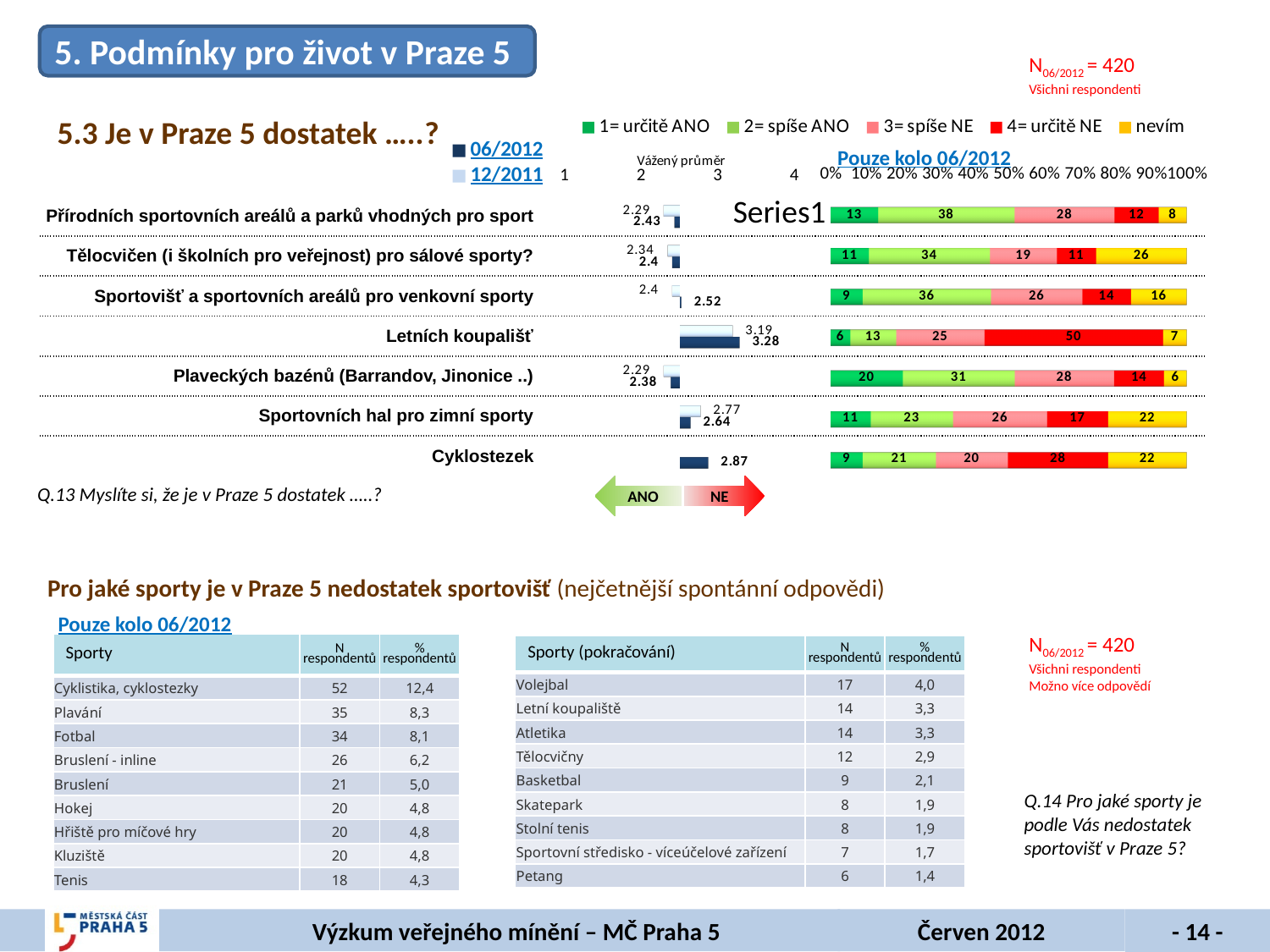
In the 'Vážený průměr' chart, what is the 06/2012 weighted average for 'Letních koupališť'? 3.28 How many categories are shown in the 'Pouze kolo 06/2012' stacked chart? 7 How many series does the legend of the 'Pouze kolo 06/2012' stacked chart list? 5 In the 'Vážený průměr' chart, what is the difference between the 12/2011 and 06/2012 values for 'Přírodních sportovních areálů a parků vhodných pro sport'? 0.14 In the 'Vážený průměr' chart, what is the 12/2011 weighted average for 'Sportovišť a sportovních areálů pro venkovní sporty'? 2.4 What kind of chart is the 'Pouze kolo 06/2012' chart? Stacked bar chart In the 'Pouze kolo 06/2012' stacked chart, what percentage answered '4= určitě NE' for 'Letních koupališť'? 50 In the 'Pouze kolo 06/2012' stacked chart, what percentage answered '1= určitě ANO' for 'Plaveckých bazénů (Barrandov, Jinonice ..)'? 20 In the 'Vážený průměr' chart, which category has the highest 06/2012 weighted average? Letních koupališť In the 'Vážený průměr' chart, which is larger for 'Sportovních hal pro zimní sporty': the 06/2012 value or the 12/2011 value? 12/2011 In the 'Pouze kolo 06/2012' stacked chart, what is the combined percentage of '1= určitě ANO' and '2= spíše ANO' for 'Cyklostezek'? 30 In the 'Pouze kolo 06/2012' stacked chart, what percentage answered 'nevím' for 'Tělocvičen (i školních pro veřejnost) pro sálové sporty?'? 26